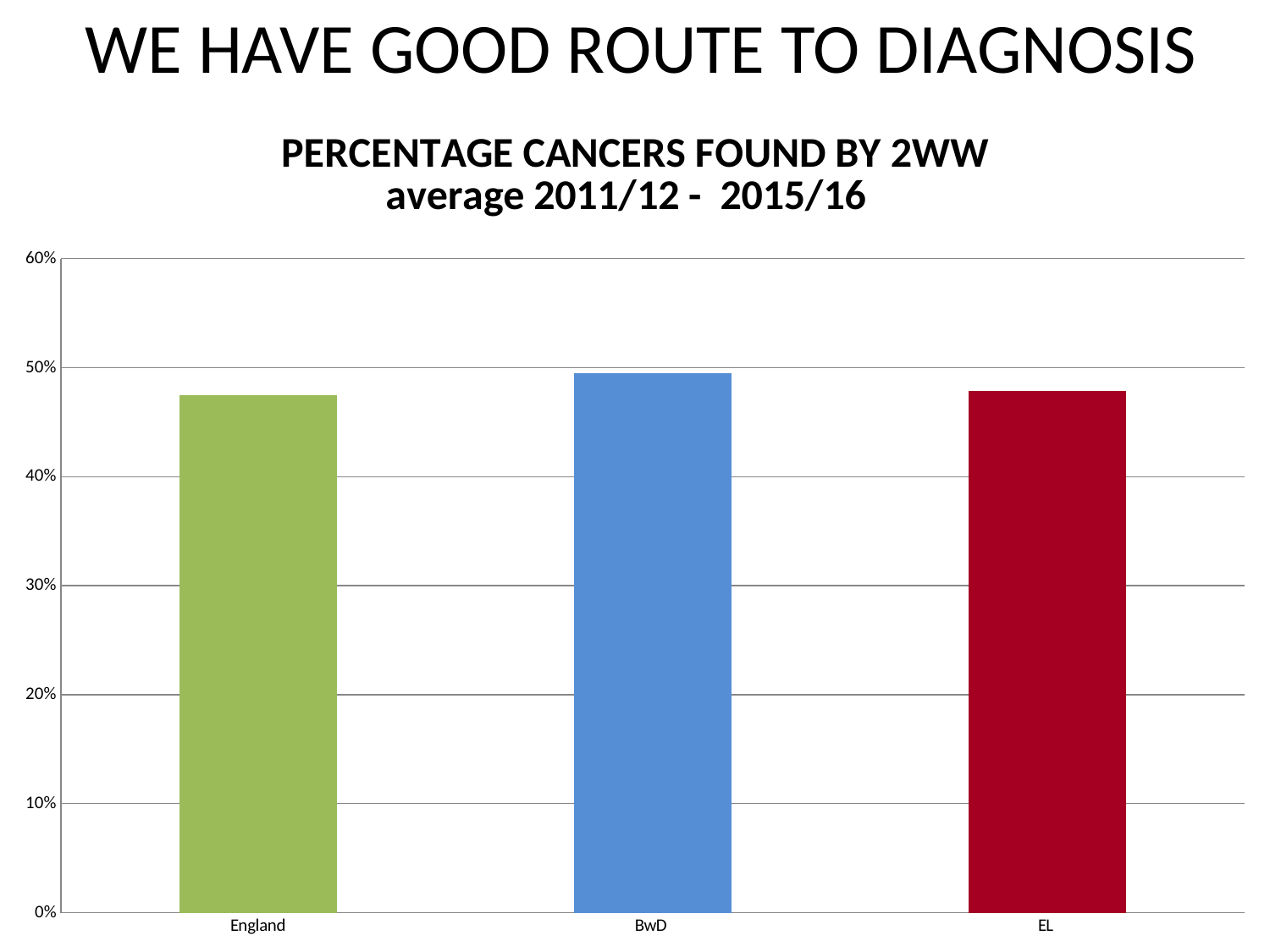
What kind of chart is shown on the slide? bar chart Is the value for BwD greater or less than 40%? greater What is the highest value shown on the vertical axis? 60% Is the value for England greater or less than 50%? less Is the value for EL greater or less than 50%? less Which is larger, the value for BwD or the value for England? BwD How many categories are plotted on the chart? 3 Which category has the highest percentage of cancers found by 2WW? BwD What is the title of the chart? PERCENTAGE CANCERS FOUND BY 2WW average 2011/12 - 2015/16